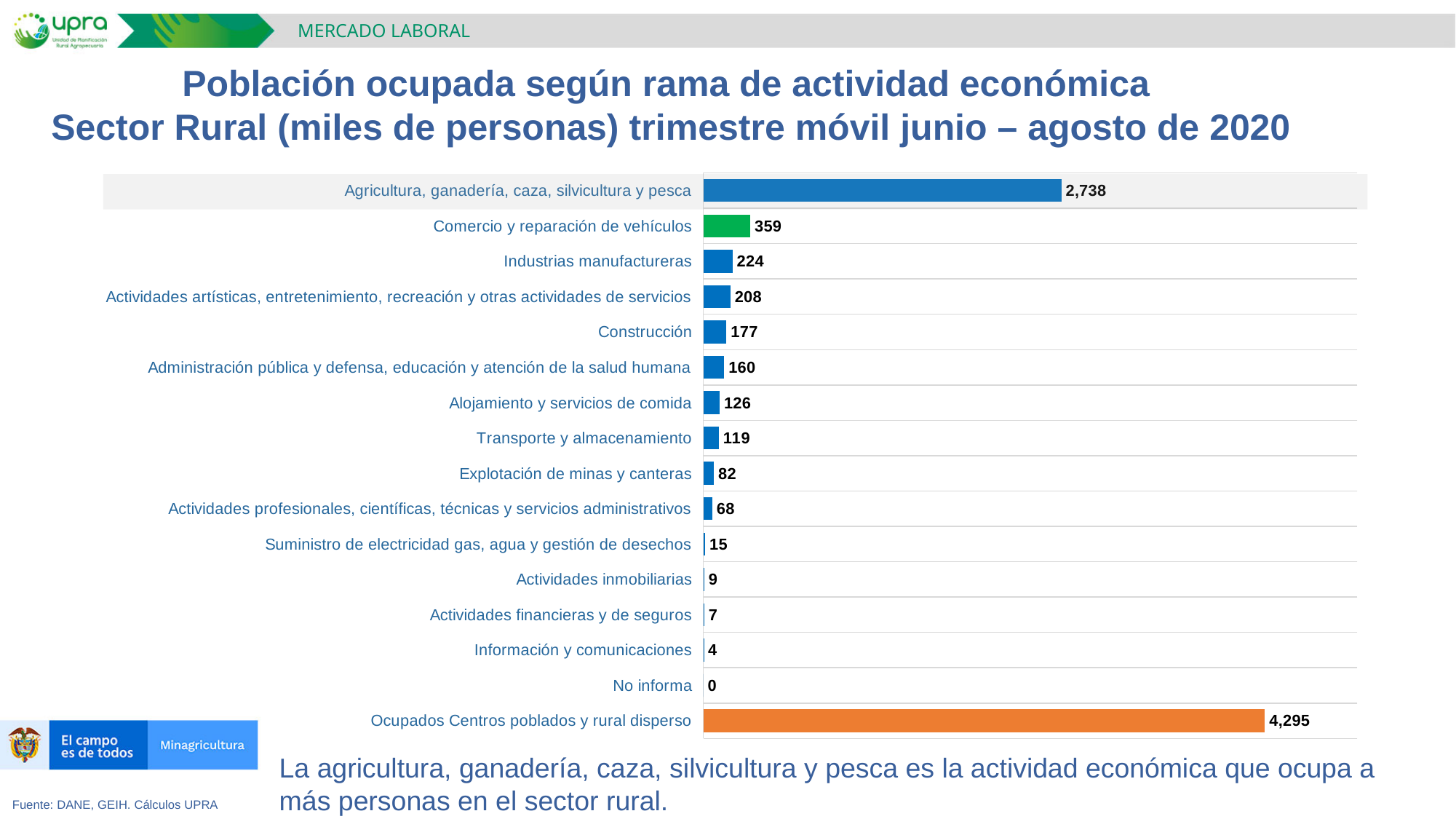
What is the difference between the values for Agricultura, ganadería, caza, silvicultura y pesca and Comercio y reparación de vehículos? 2,379 What is the value for Explotación de minas y canteras? 82 Which is larger, the value for Industrias manufactureras or the value for Alojamiento y servicios de comida? Industrias manufactureras What is the value for Comercio y reparación de vehículos? 359 What type of chart is shown on the slide? bar chart What is the value for Agricultura, ganadería, caza, silvicultura y pesca? 2,738 What is the title of the chart on the slide? Población ocupada según rama de actividad económica Sector Rural (miles de personas) trimestre móvil junio – agosto de 2020 What is the value for Construcción? 177 Which category has the longest bar in the chart? Ocupados Centros poblados y rural disperso How many categories are plotted in the chart? 16 What is the value for Ocupados Centros poblados y rural disperso? 4,295 Which category has the lowest value in the chart? No informa